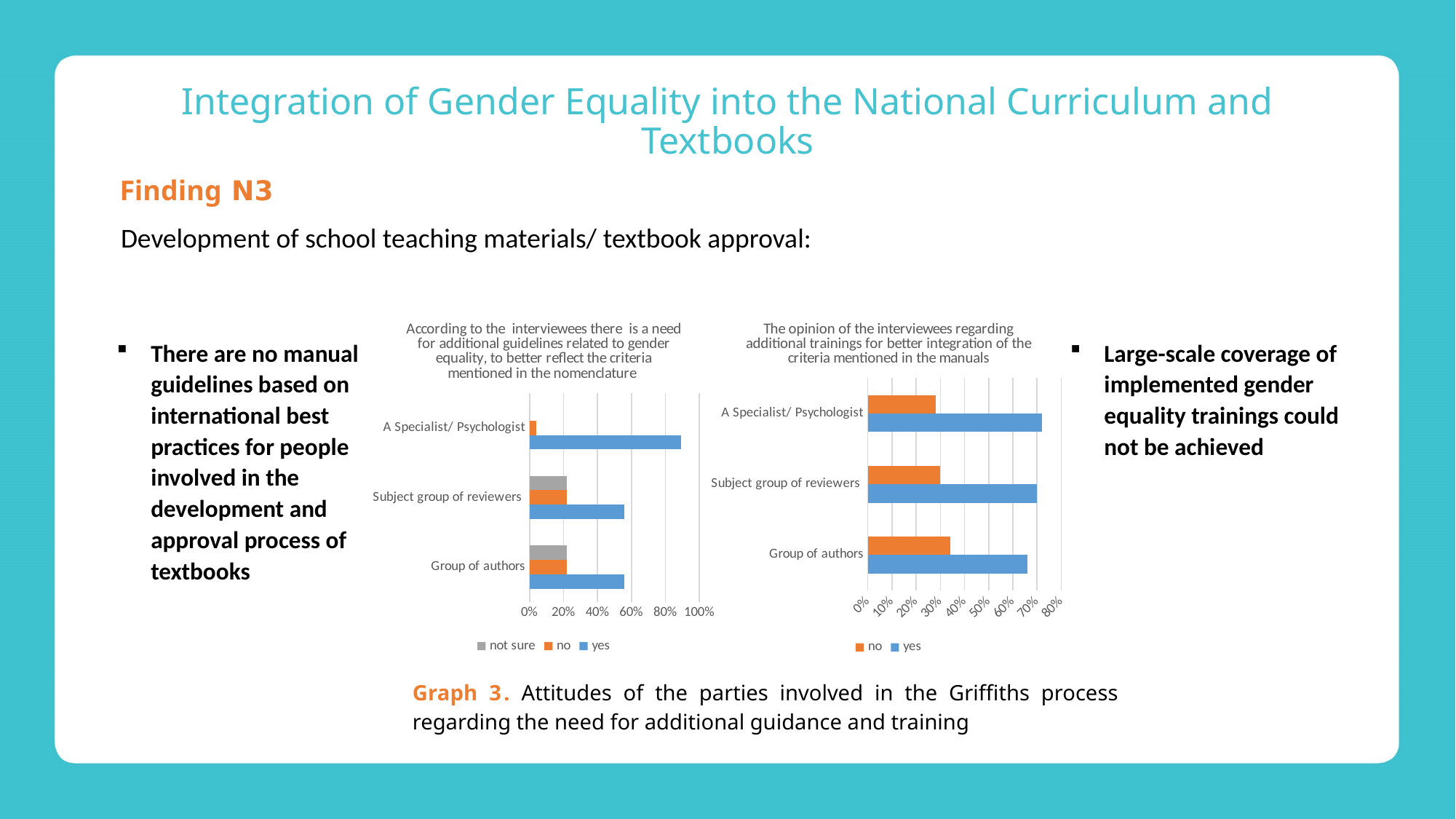
In the right chart (about additional trainings), is the 'no' value for Group of authors greater or less than 40%? less In the left chart (about additional guidelines), which category has the highest 'yes' value? A Specialist/ Psychologist In the right chart (about additional trainings), which is larger for Group of authors, the 'yes' value or the 'no' value? yes Which series appears in the legend of the left chart but not in the legend of the right chart? not sure In the left chart (about additional guidelines), is the 'no' value for A Specialist/ Psychologist greater or less than 20%? less In the left chart (about additional guidelines), is the 'yes' value for Group of authors greater or less than 40%? greater How many series does the legend of the left chart (about additional guidelines) list? 3 How many series does the legend of the right chart (about additional trainings) list? 2 What kind of chart is the left chart, titled 'According to the interviewees there is a need for additional guidelines...'? bar chart How many categories are shown on the right chart (about additional trainings)? 3